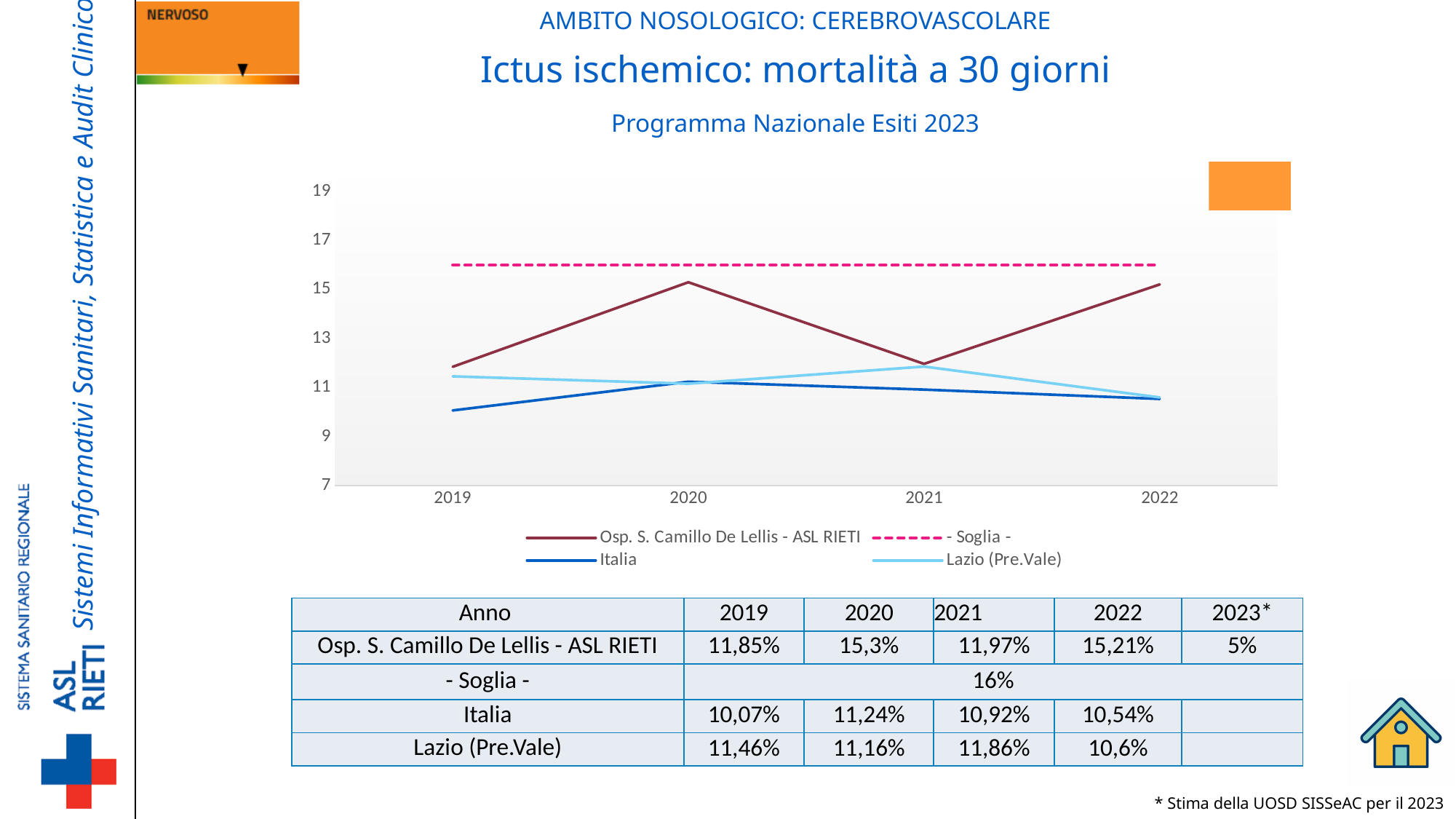
What is the value of the Soglia line? 16% How many years are shown on the x axis of the chart? 4 Is the value for Osp. S. Camillo De Lellis - ASL RIETI in 2020 greater or less than 15? greater What is the value for Osp. S. Camillo De Lellis - ASL RIETI in 2020? 15,3% What is the value for Italia in 2019? 10,07% What is the value for Lazio (Pre.Vale) in 2022? 10,6% How many series does the chart legend list? 4 In which year is the value for Italia lowest? 2019 Which is larger in 2020: Osp. S. Camillo De Lellis - ASL RIETI or Italia? Osp. S. Camillo De Lellis - ASL RIETI What is the difference between Osp. S. Camillo De Lellis - ASL RIETI and Italia in 2022? 4,67% What kind of chart is shown on the slide? Line chart In which year is the value for Lazio (Pre.Vale) highest? 2021